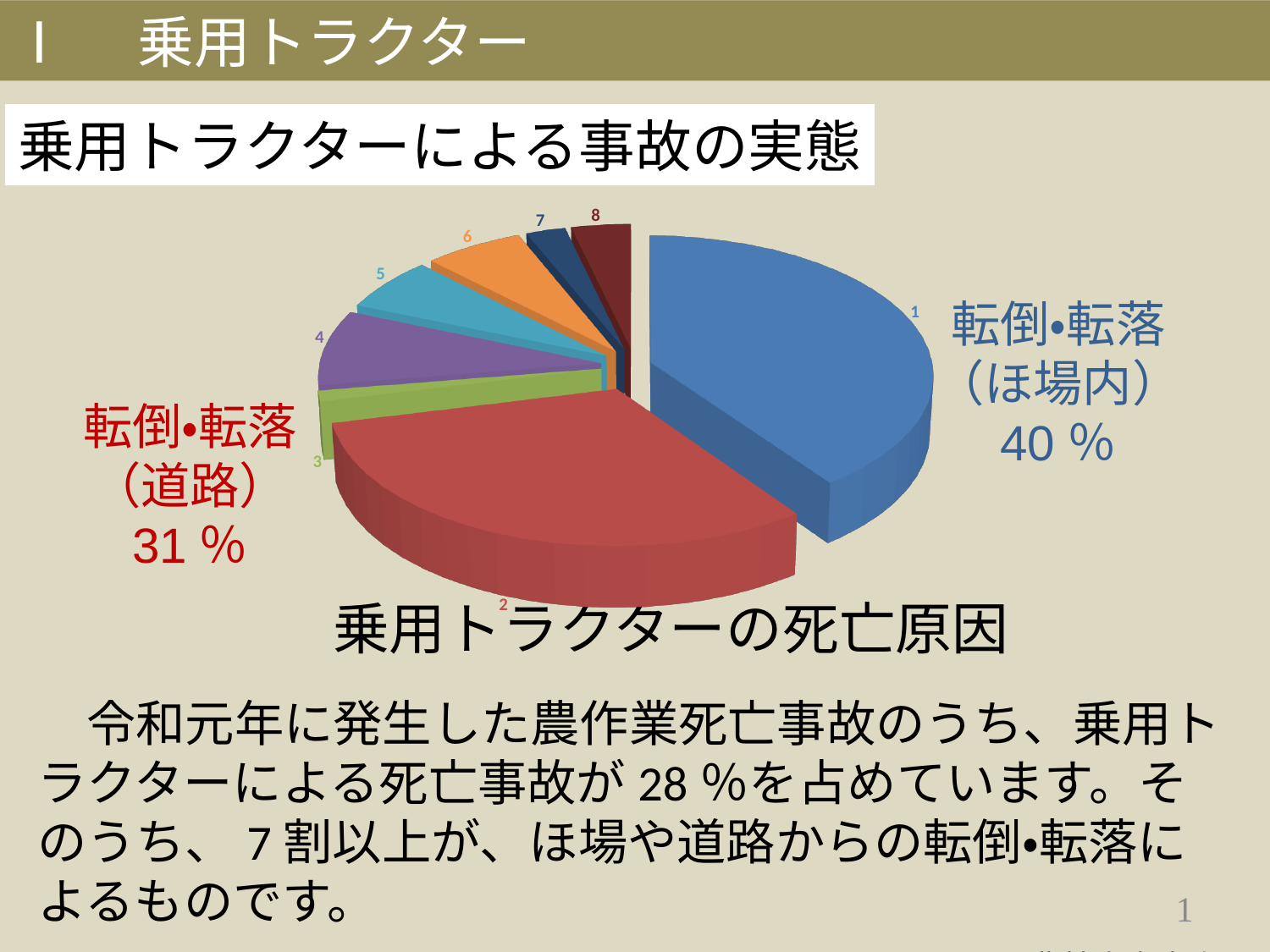
What is the combined share of 転倒・転落（ほ場内） and 転倒・転落（道路）? 71 % By how many percentage points does 転倒・転落（ほ場内） exceed 転倒・転落（道路）? 9 How many slices does the pie chart have? 8 What share of the pie is labelled 転倒・転落（道路）? 31 % Which category has the largest slice of the pie? 転倒・転落（ほ場内） What is the title of the pie chart? 乗用トラクターの死亡原因 Which is larger, the slice for 転倒・転落（ほ場内） or the slice for 転倒・転落（道路）? 転倒・転落（ほ場内） What share of the pie is labelled 転倒・転落（ほ場内）? 40 % Which slice number corresponds to 転倒・転落（道路）? 2 What colour is the slice labelled 転倒・転落（ほ場内）? blue What kind of chart is shown on the slide? pie chart